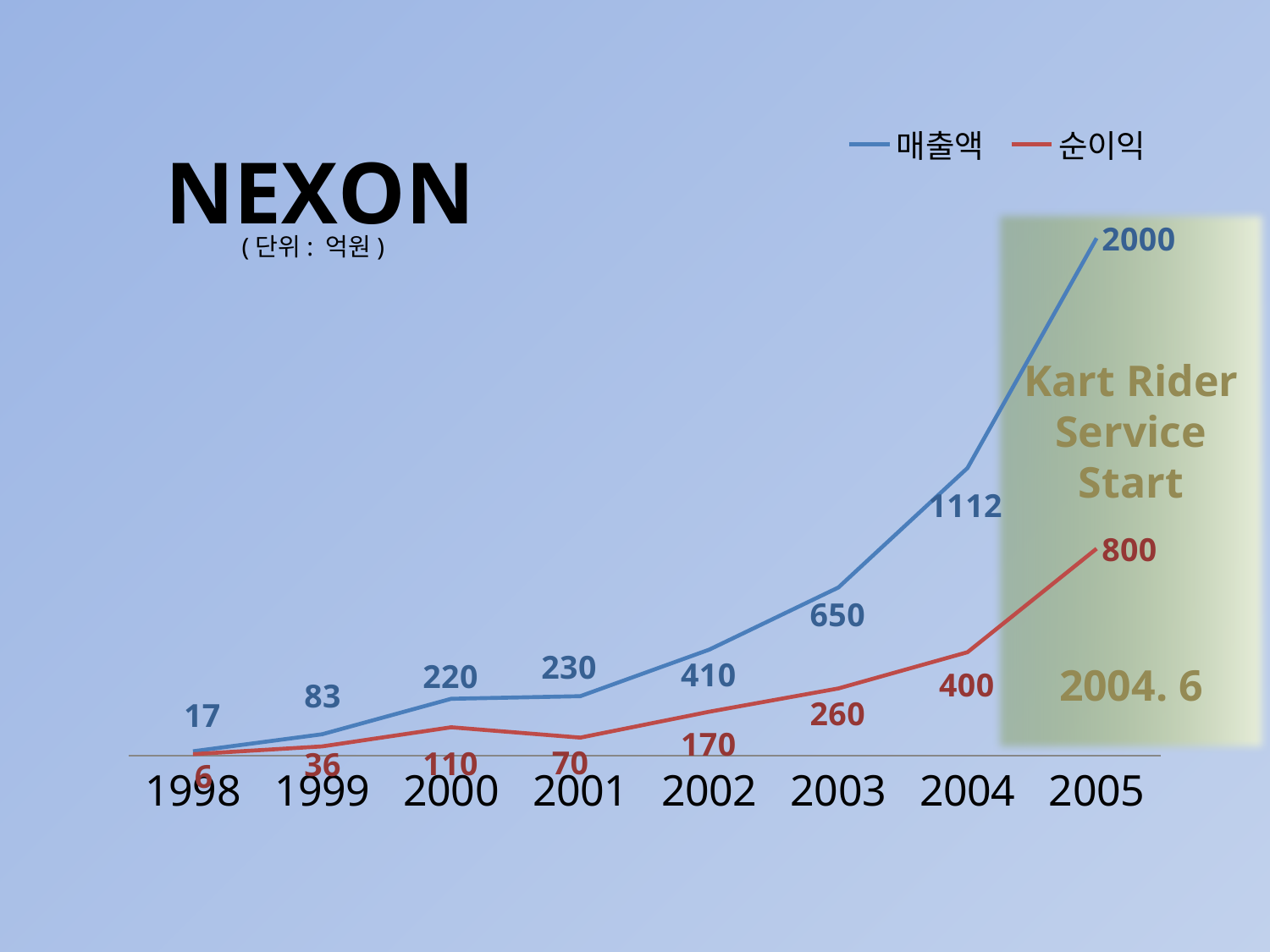
What type of chart is shown on the slide? line chart How many series does the legend list? 2 Does 매출액 rise or fall from 1998 to 2005? rise In which year is 순이익 lowest? 1998 What is the 매출액 value for 2004? 1112 How many years are plotted on the x axis? 8 What is the difference between 매출액 and 순이익 in 2005? 1200 What is the 매출액 value for 2003? 650 What unit is stated below the chart title? 억원 Which is larger, 순이익 in 2000 or 순이익 in 2001? 2000 What is the 순이익 value for 2001? 70 In which year is 매출액 highest? 2005